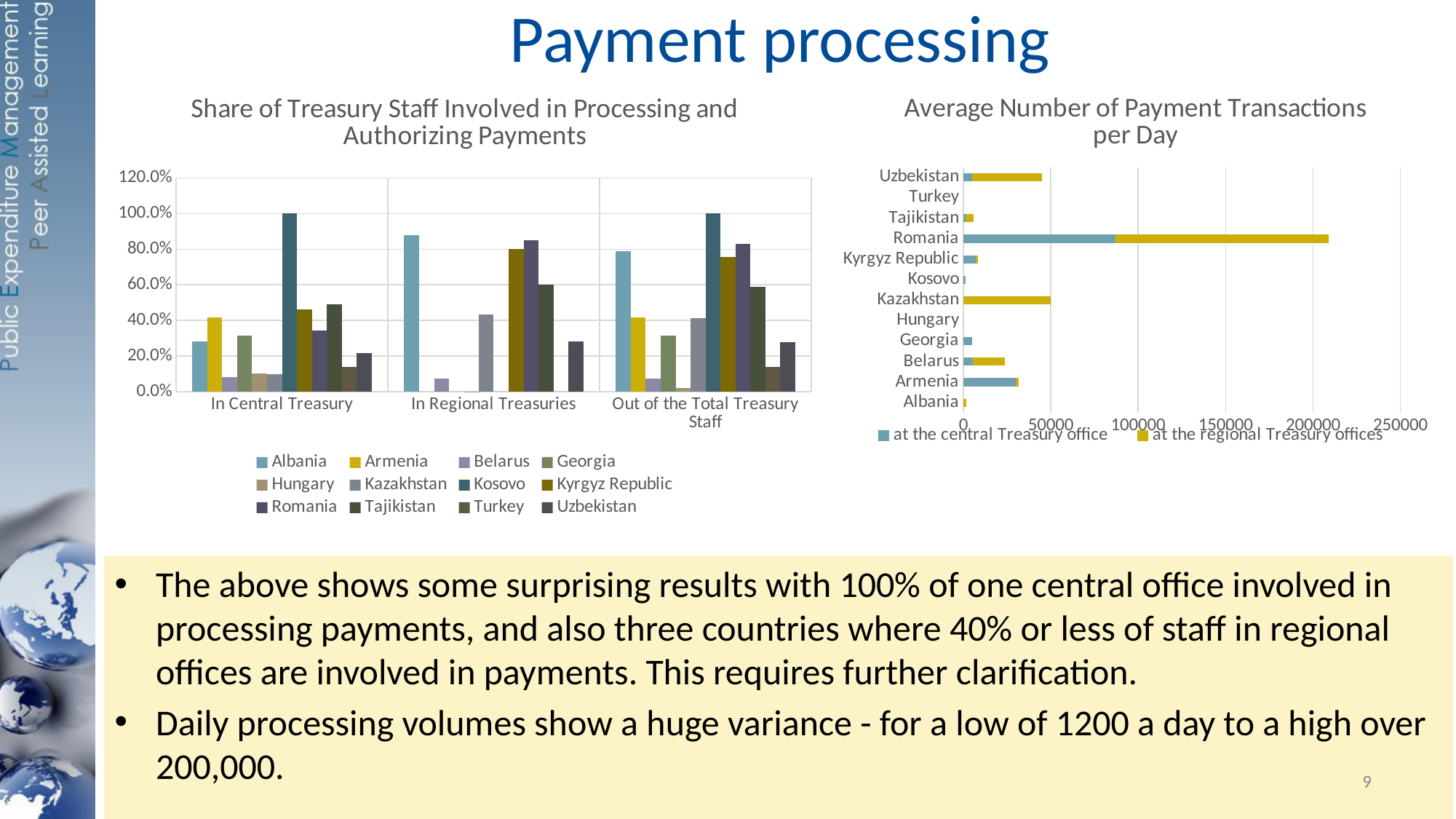
What type of chart is the 'Average Number of Payment Transactions per Day' chart? bar chart In the 'Share of Treasury Staff Involved in Processing and Authorizing Payments' chart, which is larger for In Central Treasury: Armenia or Albania? Armenia In the 'Average Number of Payment Transactions per Day' chart, is the total for Uzbekistan greater or less than 50000? less In the 'Share of Treasury Staff Involved in Processing and Authorizing Payments' chart, is the value for Albania in the In Regional Treasuries category greater or less than 80.0%? greater How many countries are listed on the 'Average Number of Payment Transactions per Day' chart? 12 In the 'Share of Treasury Staff Involved in Processing and Authorizing Payments' chart, which country has the highest value for In Central Treasury? Kosovo How many series does the legend of the 'Average Number of Payment Transactions per Day' chart list? 2 How many series does the legend of the 'Share of Treasury Staff Involved in Processing and Authorizing Payments' chart list? 12 How many categories are shown on the x axis of the 'Share of Treasury Staff Involved in Processing and Authorizing Payments' chart? 3 What type of chart is the 'Share of Treasury Staff Involved in Processing and Authorizing Payments' chart? bar chart In the 'Share of Treasury Staff Involved in Processing and Authorizing Payments' chart, what is the value for Kosovo in the In Central Treasury category? 100.0% In the 'Average Number of Payment Transactions per Day' chart, which country has the highest total? Romania